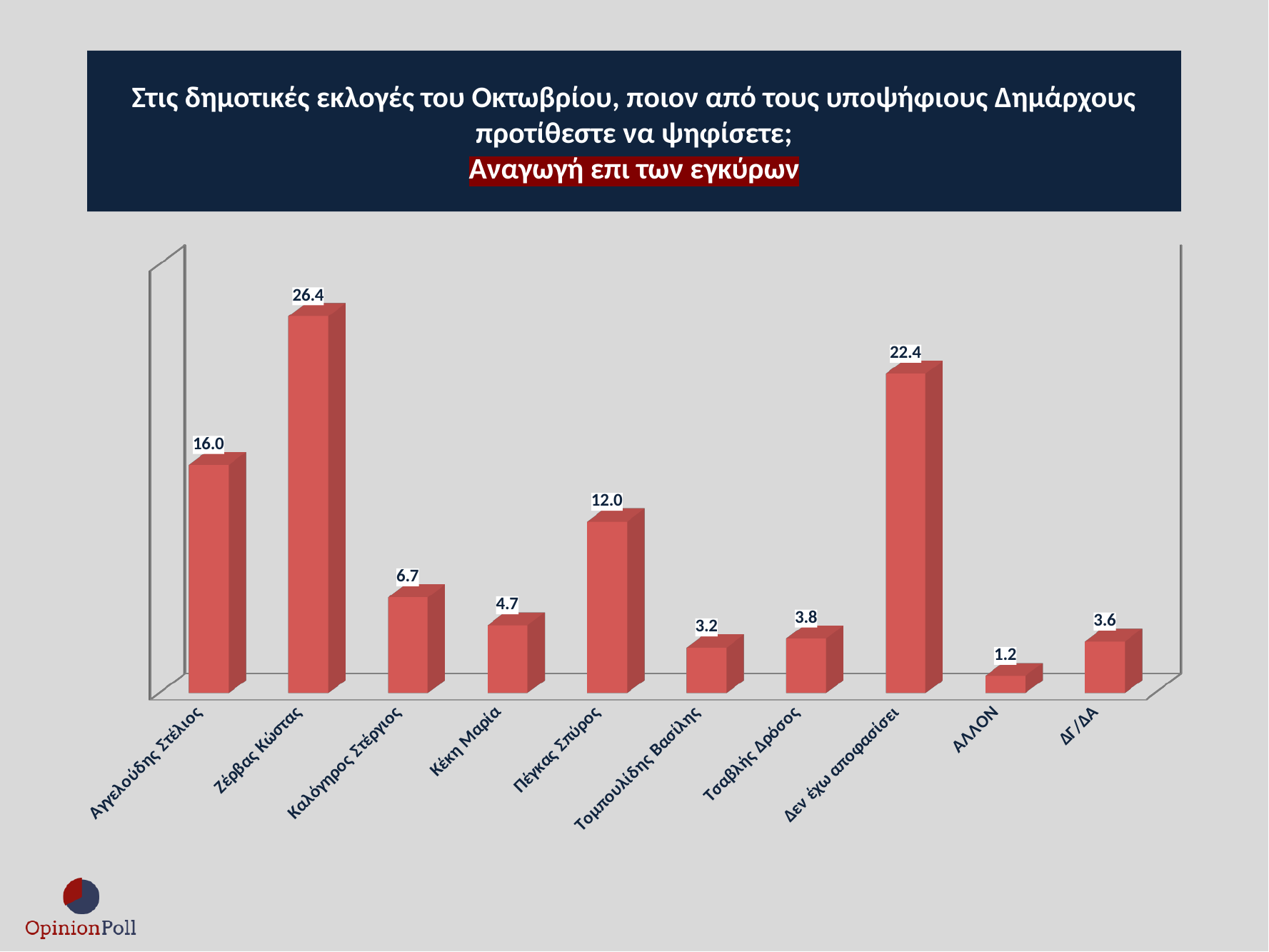
What is the value for ΔΓ/ΔΑ? 3.6 Which category has the lowest value? ΑΛΛΟΝ What is the value for Κέκη Μαρία? 4.7 Which category has the highest value? Ζέρβας Κώστας What is the difference between the values for Ζέρβας Κώστας and Αγγελούδης Στέλιος? 10.4 What is the difference between the values for Πέγκας Σπύρος and Καλόγηρος Στέργιος? 5.3 Which is larger, the value for Τσαβλής Δρόσος or the value for Τομπουλίδης Βασίλης? Τσαβλής Δρόσος What is the value for Ζέρβας Κώστας? 26.4 What kind of chart is shown on the slide? Bar chart What is the value for Δεν έχω αποφασίσει? 22.4 What colour are the bars in the chart? Red How many categories are shown on the x axis? 10